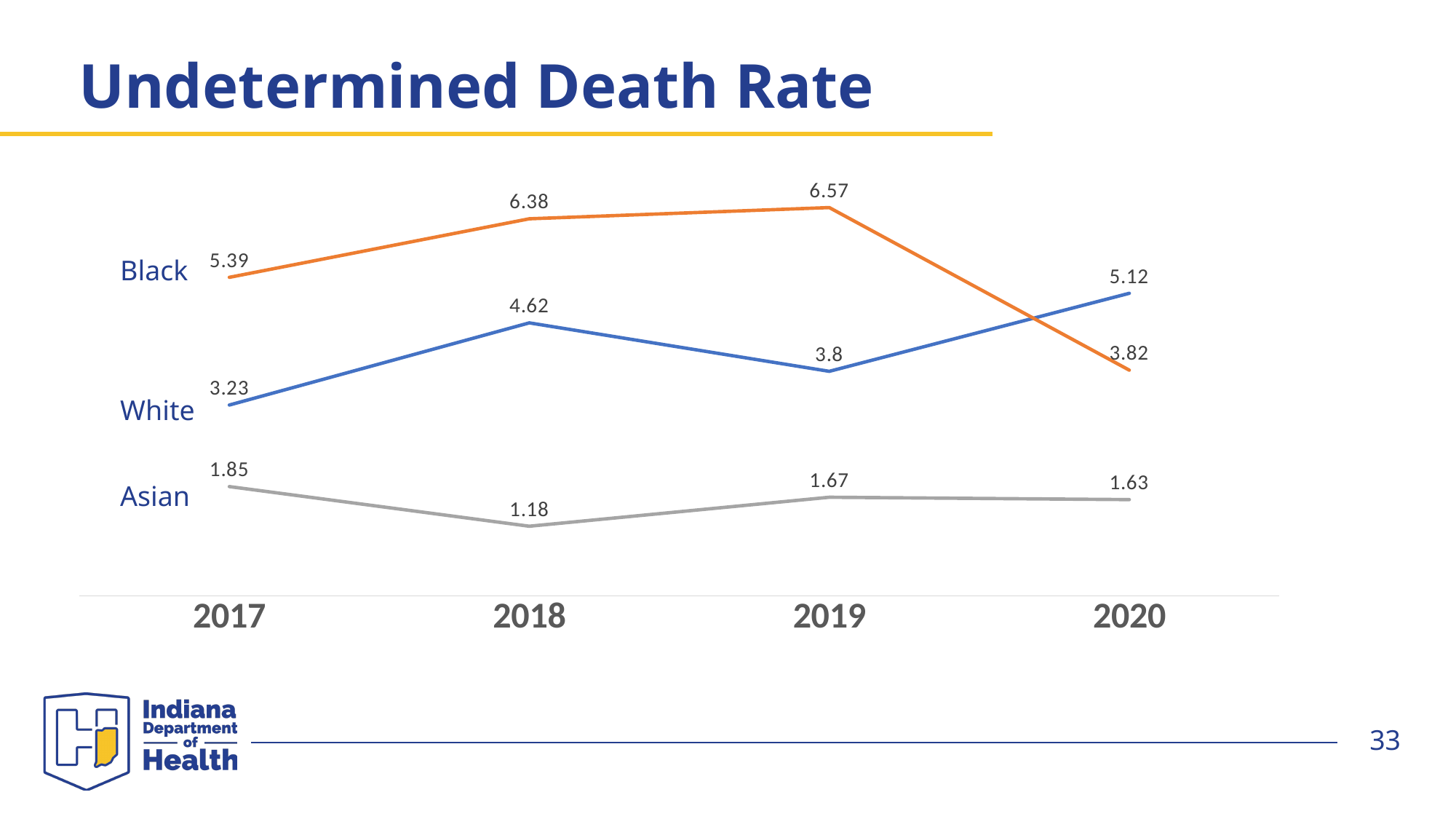
What is the undetermined death rate for Black in 2019? 6.57 What kind of chart is shown on the slide? Line chart In which year is the Asian undetermined death rate lowest? 2018 In which year is the Black undetermined death rate highest? 2019 How many years are shown on the x axis? 4 What is the title of the chart? Undetermined Death Rate How many series (groups) are plotted on the chart? 3 What is the undetermined death rate for White in 2020? 5.12 Does the Black undetermined death rate rise or fall from 2019 to 2020? Fall Which group has the higher undetermined death rate in 2020, Black or White? White What is the undetermined death rate for Asian in 2018? 1.18 What is the difference between the Black and White undetermined death rates in 2018? 1.76